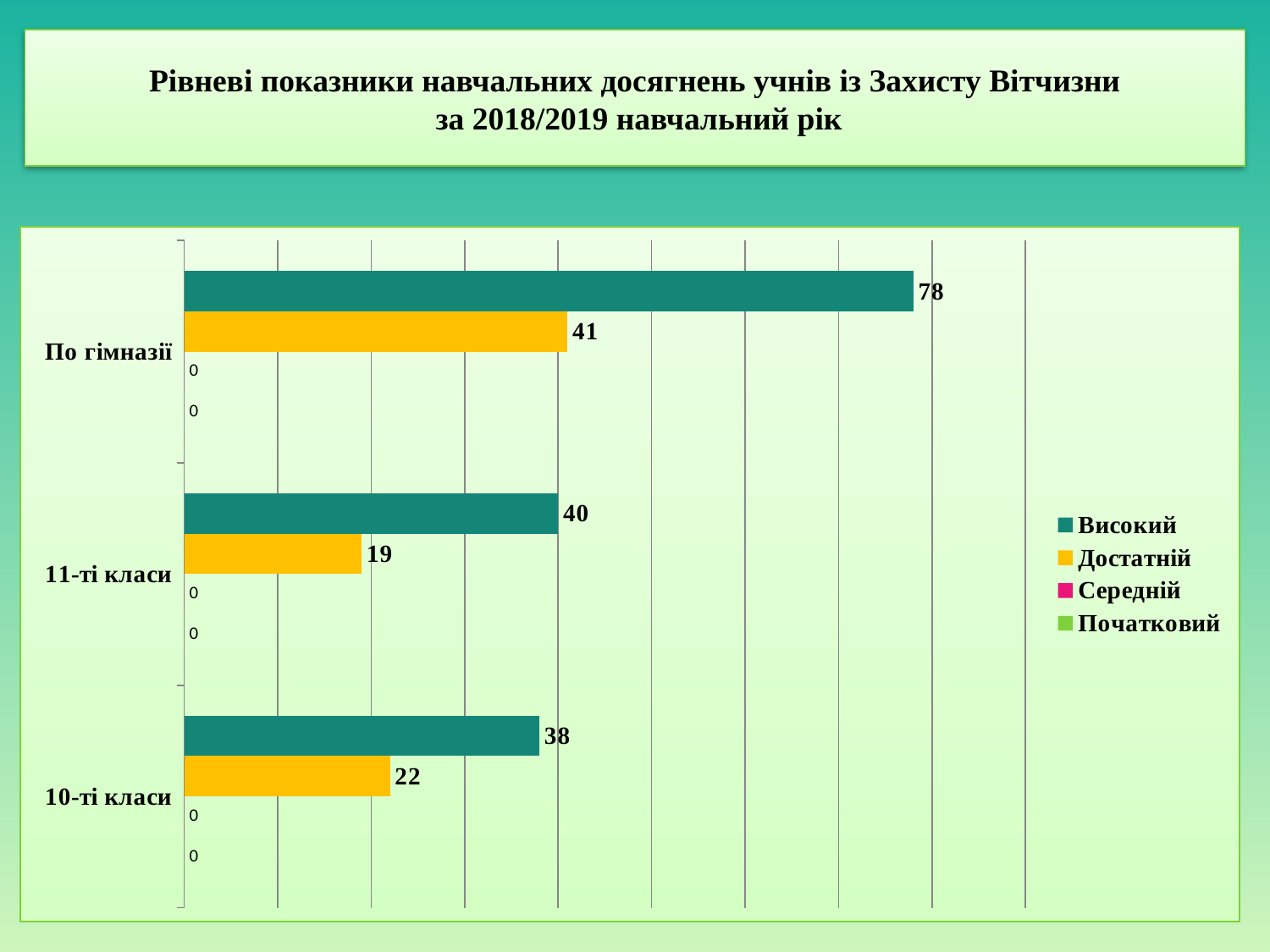
What is the value of Достатній for 11-ті класи? 19 What is the value of Високий for По гімназії? 78 How many categories are shown on the chart? 3 What is the value of Достатній for 10-ті класи? 22 Which category has the highest Високий value? По гімназії Which is larger: the Достатній value for 10-ті класи or for 11-ті класи? 10-ті класи What is the value of Середній for 11-ті класи? 0 Which category has the lowest Достатній value? 11-ті класи What is the difference between the Високий values for По гімназії and 11-ті класи? 38 What kind of chart is shown on the slide? Bar chart Which series is shown in yellow in the legend? Достатній How many series does the legend list? 4